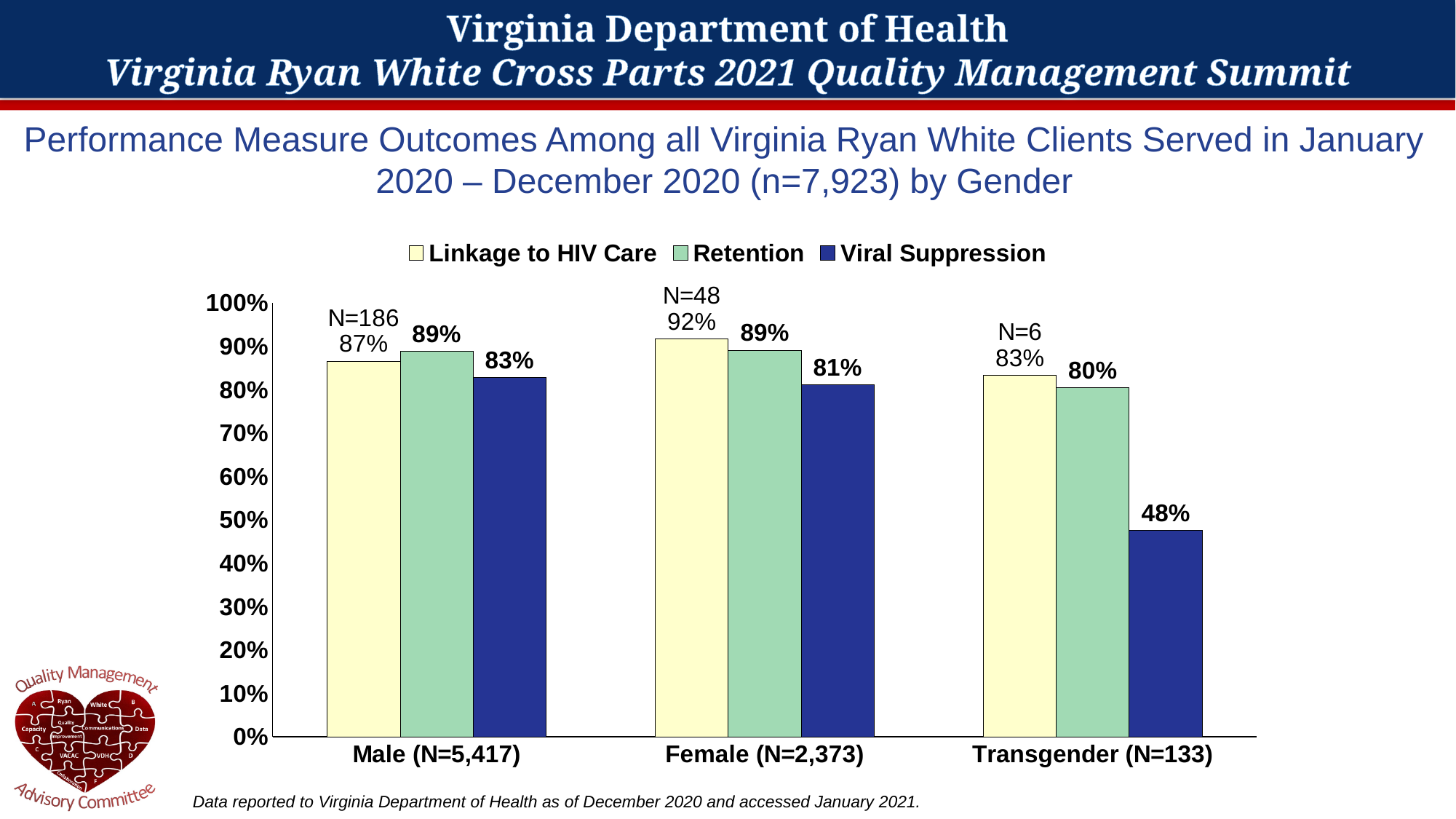
Is the Viral Suppression value for Transgender (N=133) greater or less than 50%? less How many series does the legend list? 3 What is the difference between the Linkage to HIV Care values for Female (N=2,373) and Male (N=5,417)? 5% What is the Viral Suppression value for Transgender (N=133)? 48% Which is larger: the Viral Suppression value for Male (N=5,417) or for Female (N=2,373)? Male (N=5,417) What is the Linkage to HIV Care value for Female (N=2,373)? 92% How many gender categories are shown on the x axis? 3 Which gender category has the highest Linkage to HIV Care value? Female (N=2,373) What kind of chart is shown on the slide? Bar chart Which gender category has the lowest Viral Suppression value? Transgender (N=133) What is the Retention value for Male (N=5,417)? 89% What is the difference between the Retention and Viral Suppression values for Transgender (N=133)? 32%